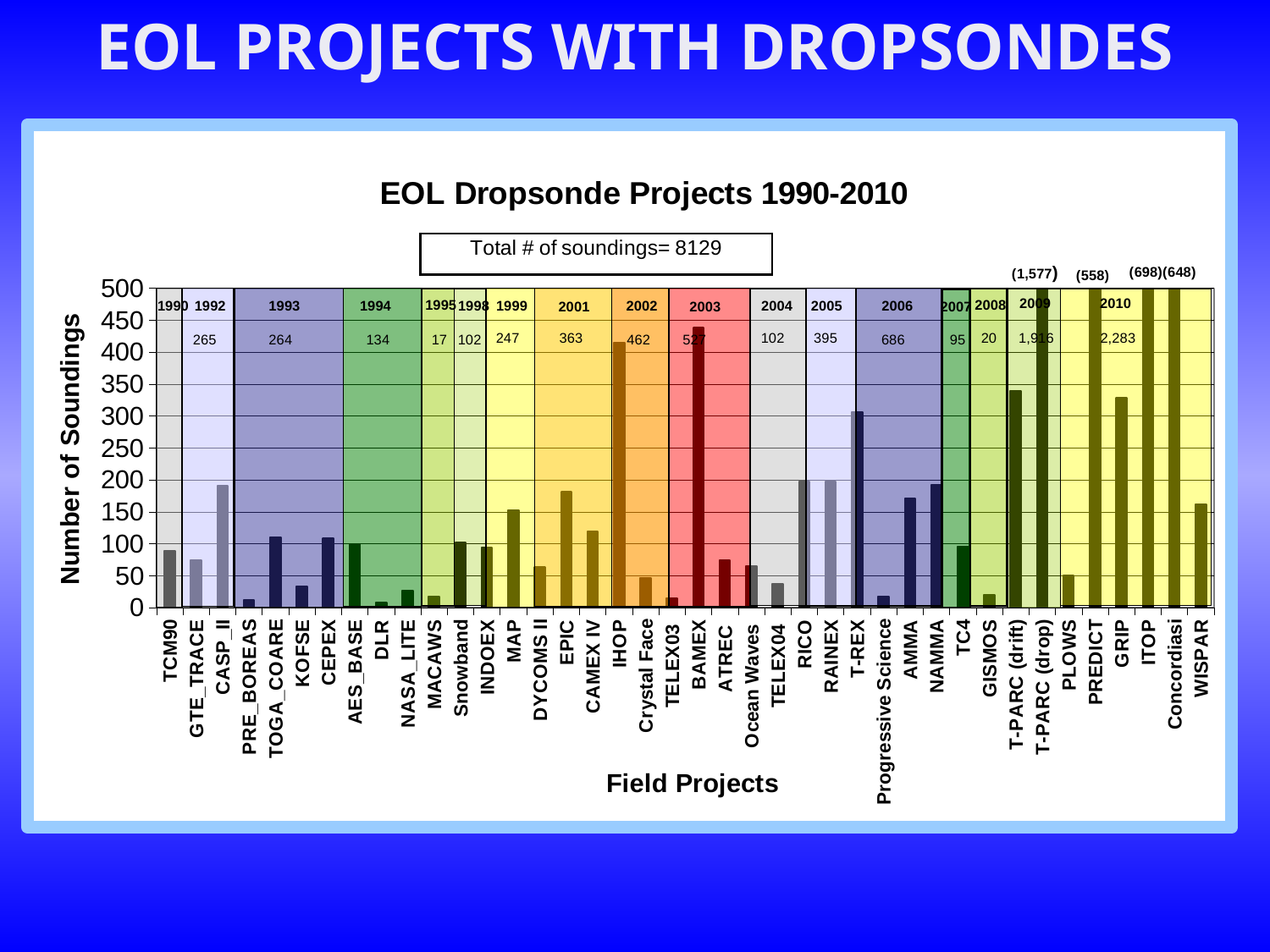
What is the number of soundings shown for the year 2010? 2,283 How many soundings are labelled for Concordiasi? 648 How many soundings are labelled for T-PARC (drop)? 1,577 What is the title of the chart? EOL Dropsonde Projects 1990-2010 What is the total number of soundings stated on the chart? 8129 How many soundings are labelled for ITOP? 698 What is the number of soundings shown for the year 2006? 686 What is the difference in soundings between ITOP and Concordiasi? 50 Which field project has the highest number of soundings? T-PARC (drop) What kind of chart is shown on the slide? Bar chart Is the value for IHOP greater or less than 400? greater Is the value for TELEX03 greater or less than 50? less